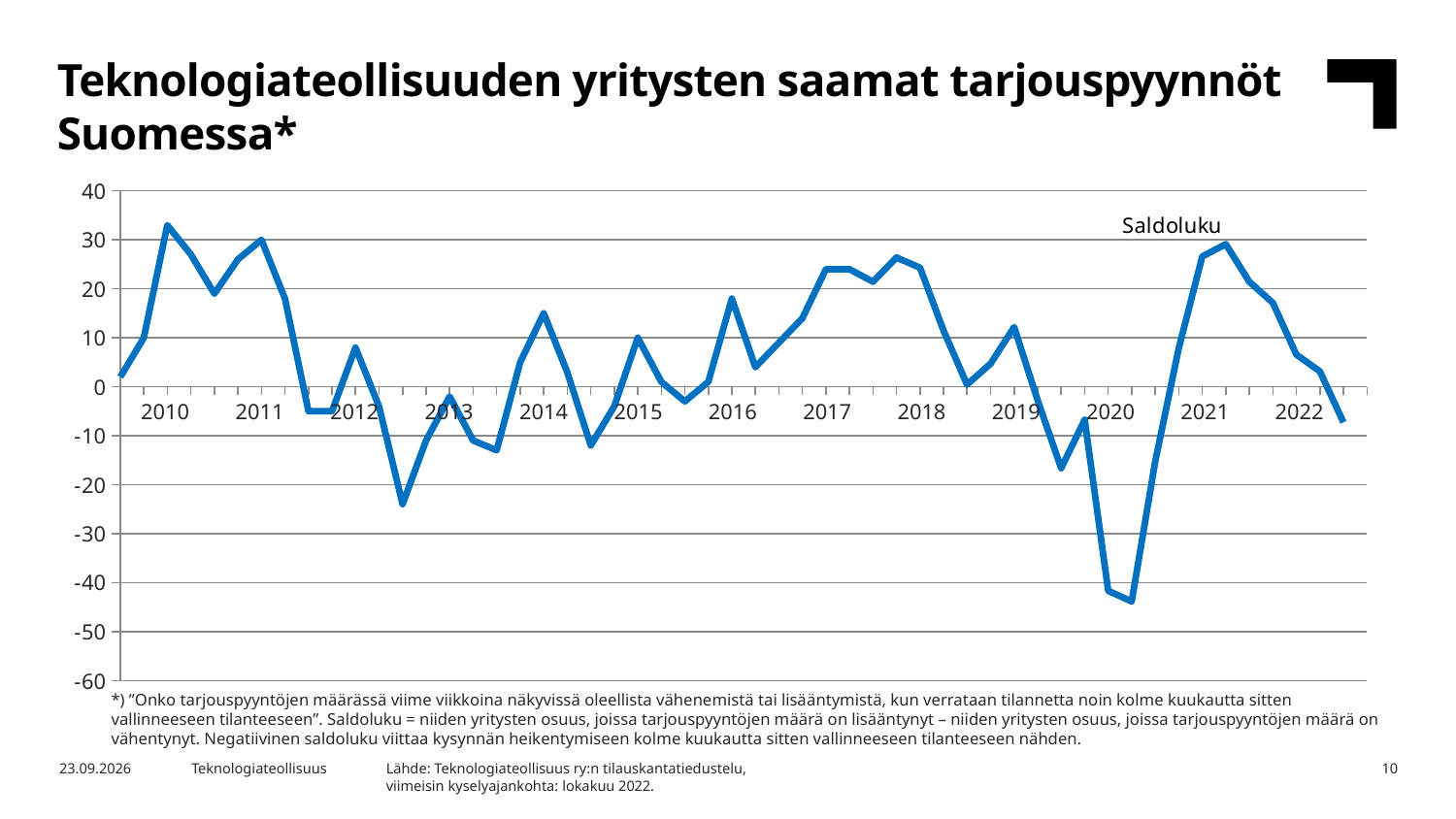
What is the title of the chart on the slide? Teknologiateollisuuden yritysten saamat tarjouspyynnöt Suomessa* Is the lowest value of the line in 2012 greater or less than -10? less In which year does the line reach its lowest point? 2020 Is the lowest value of the line in 2020 greater or less than -30? less Is the last plotted value at the end of 2022 greater or less than 0? less What kind of chart is shown on the slide? line chart What is the name of the series plotted in the chart? Saldoluku How many years are labelled on the x axis? 13 From the 2021 peak to the end of 2022, do the values rise or fall? fall How many series does the chart plot? 1